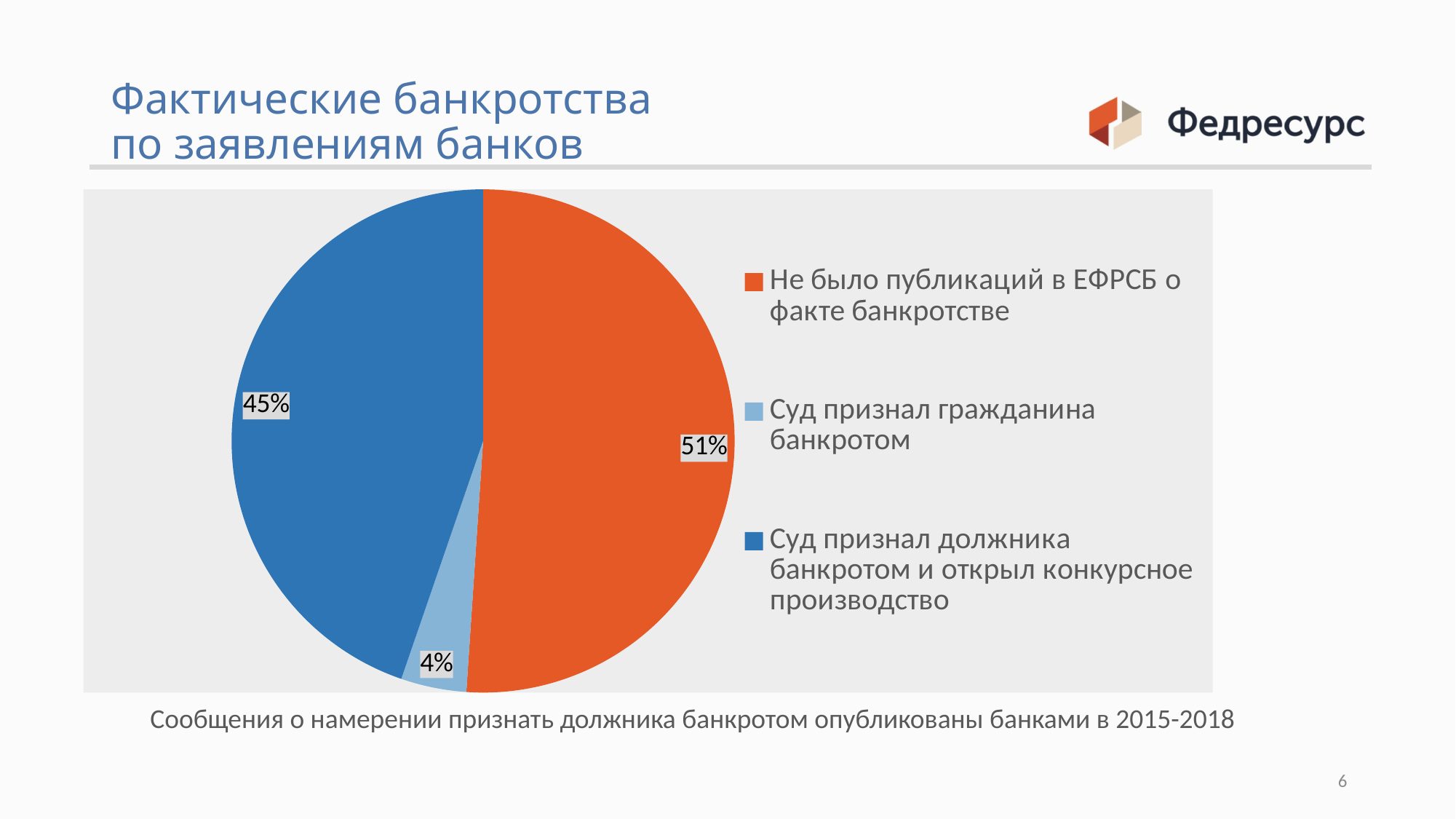
What share of the pie is labelled "Суд признал должника банкротом и открыл конкурсное производство"? 45% Which category has the largest slice of the pie? Не было публикаций в ЕФРСБ о факте банкротстве Which category has the smallest slice of the pie? Суд признал гражданина банкротом How many slices does the pie chart have? 3 What share of the pie is labelled "Суд признал гражданина банкротом"? 4% What share of the pie is labelled "Не было публикаций в ЕФРСБ о факте банкротстве"? 51% Which is larger: the "Суд признал гражданина банкротом" slice or the "Суд признал должника банкротом и открыл конкурсное производство" slice? Суд признал должника банкротом и открыл конкурсное производство What colour is the slice for "Суд признал гражданина банкротом"? Light blue What is the caption below the chart? Сообщения о намерении признать должника банкротом опубликованы банками в 2015-2018 How many entries does the legend list? 3 What kind of chart is shown on the slide? Pie chart What is the difference in percentage points between the "Не было публикаций в ЕФРСБ о факте банкротстве" slice and the "Суд признал должника банкротом и открыл конкурсное производство" slice? 6 percentage points